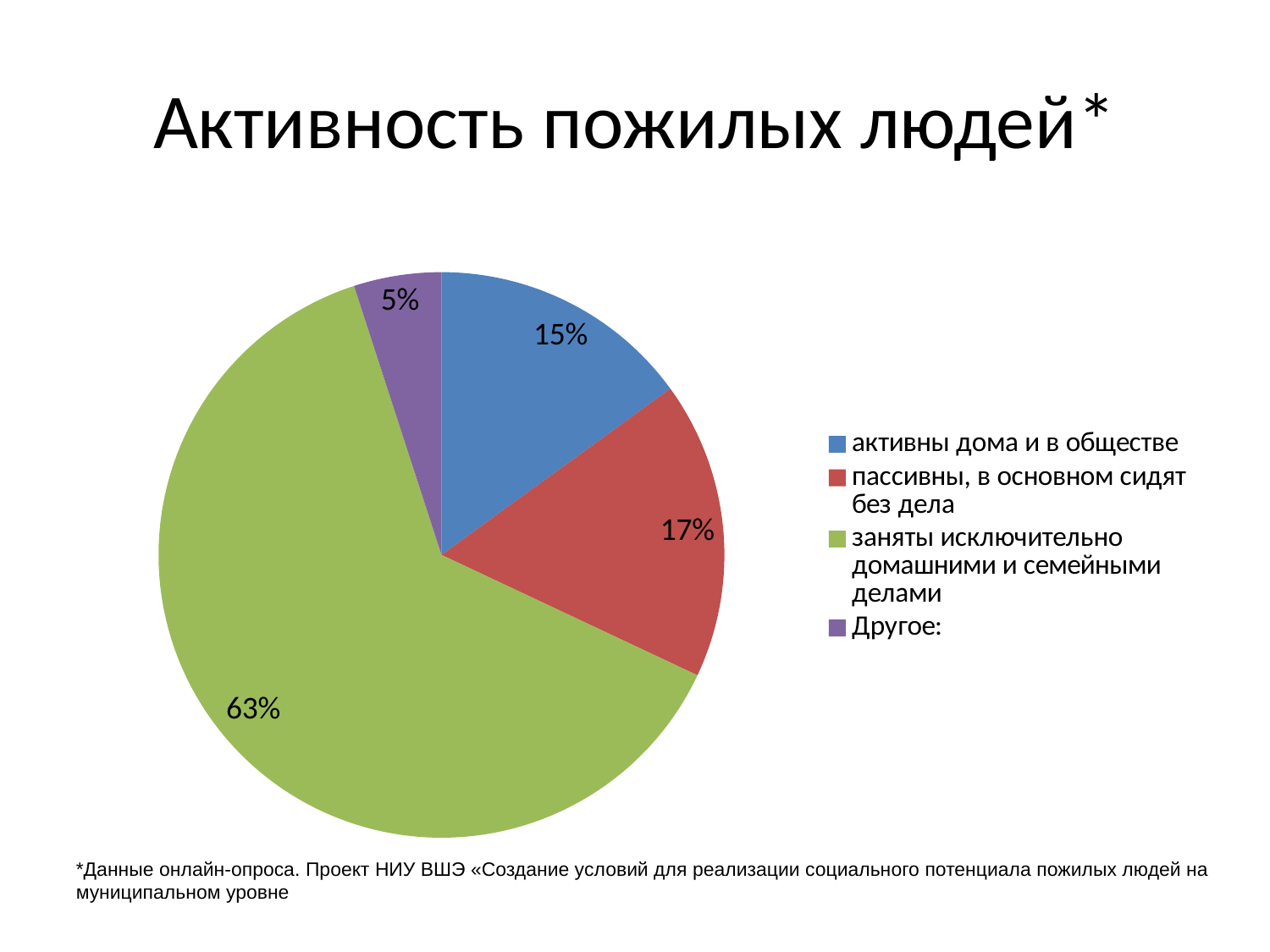
How many slices does the pie chart have? 4 Which category has the largest slice of the pie? заняты исключительно домашними и семейными делами What colour is the slice for "Другое:"? purple Which category has the smallest slice of the pie? Другое: What kind of chart is shown on the slide? pie chart What share of the pie is labelled "Другое:"? 5% What share of the pie is labelled "пассивны, в основном сидят без дела"? 17% What share of the pie is labelled "активны дома и в обществе"? 15% Which is larger: the slice for "пассивны, в основном сидят без дела" or the slice for "активны дома и в обществе"? пассивны, в основном сидят без дела What is the difference in percentage points between "заняты исключительно домашними и семейными делами" and "пассивны, в основном сидят без дела"? 46 What share of the pie is labelled "заняты исключительно домашними и семейными делами"? 63% What is the title of the chart on the slide? Активность пожилых людей*